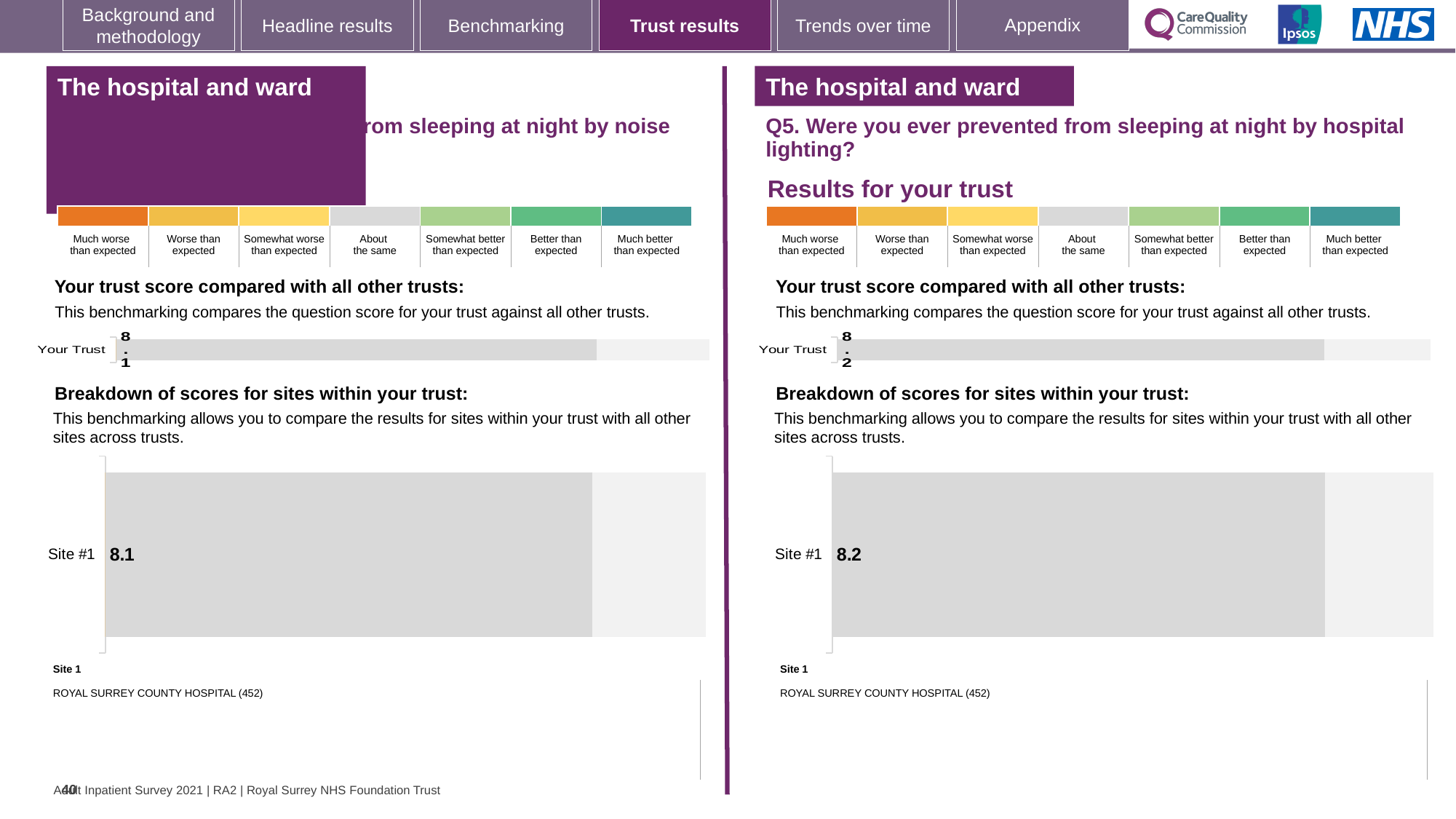
On the left half of the slide, what score is shown for "Your Trust" in the trust comparison bar chart? 8.1 How many sites are plotted in the right-hand breakdown of scores for sites chart? 1 Which hospital is listed as Site 1 beneath the right-hand site breakdown chart? ROYAL SURREY COUNTY HOSPITAL (452) In the right-hand breakdown of scores for sites chart (Q5, hospital lighting), what is the score for Site #1? 8.2 How many rating categories are shown in the colour scale above the right-hand trust comparison chart? 7 What kind of chart is used to show the Site #1 score on the right half of the slide? Bar chart What is the difference between the Site #1 score in the right-hand site breakdown chart and the Site #1 score in the left-hand site breakdown chart? 0.1 How many sites are plotted in the left-hand breakdown of scores for sites chart? 1 Which is higher: the Site #1 score in the left-hand site breakdown chart or the Site #1 score in the right-hand site breakdown chart? The right-hand chart (8.2) In the left-hand breakdown of scores for sites chart, what is the score for Site #1? 8.1 On the right half of the slide (Q5, hospital lighting), what score is shown for "Your Trust" in the trust comparison bar chart? 8.2